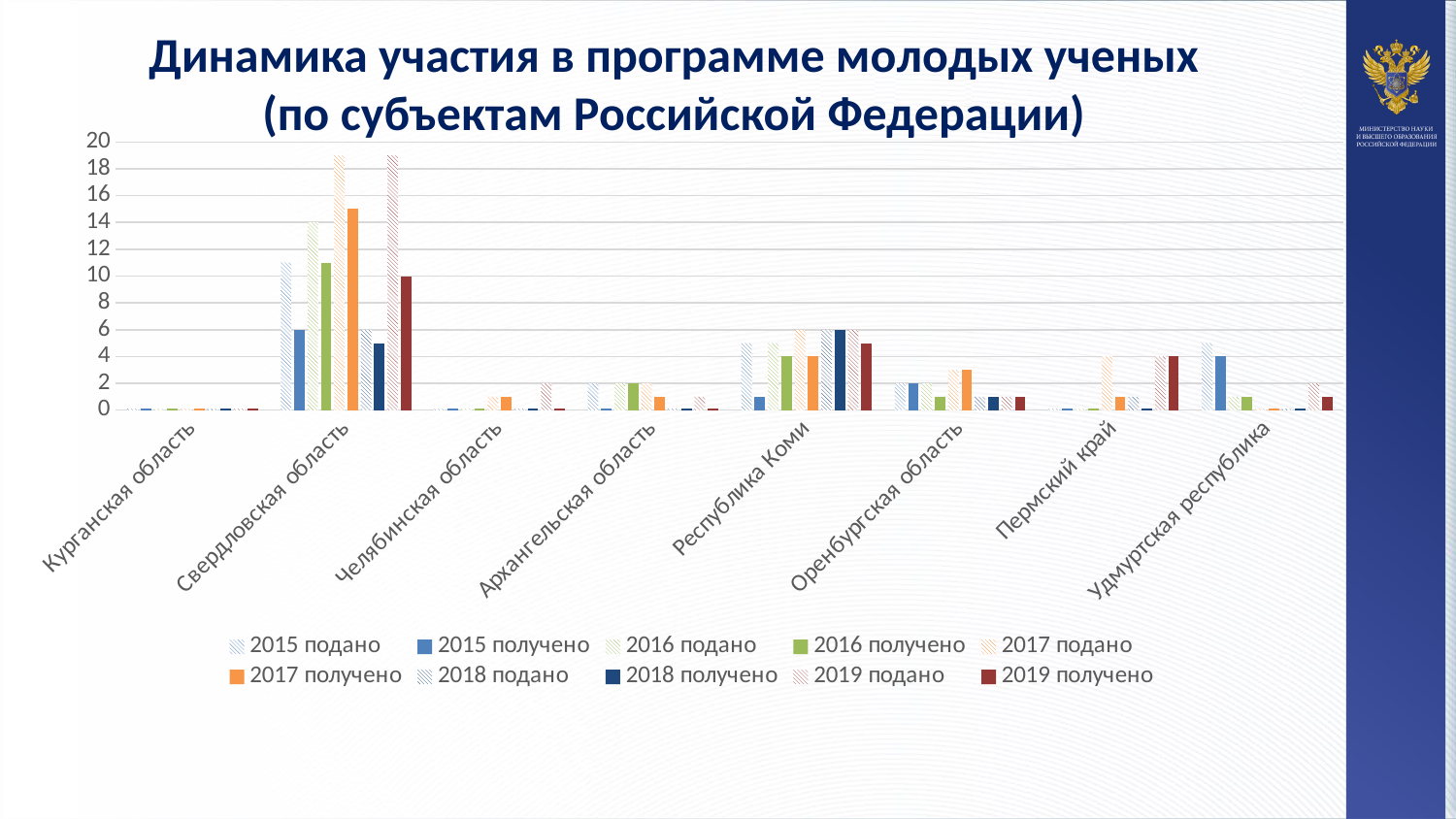
What is the value of "2018 получено" for Республика Коми? 6 What is the value of "2015 получено" for Удмуртская республика? 4 What is the title of the chart on the slide? Динамика участия в программе молодых ученых (по субъектам Российской Федерации) What is the value of "2019 получено" for Свердловская область? 10 What kind of chart is shown on the slide? bar chart Is the value of "2016 подано" for Свердловская область greater or less than 12? greater Is the value of "2017 подано" for Свердловская область greater or less than 16? greater Which region has the highest bars overall in the chart? Свердловская область Which is larger: "2017 получено" for Свердловская область or "2017 получено" for Республика Коми? Свердловская область How many series does the legend list? 10 What is the value of "2019 получено" for Пермский край? 4 How many regions (categories) are shown on the x axis? 8